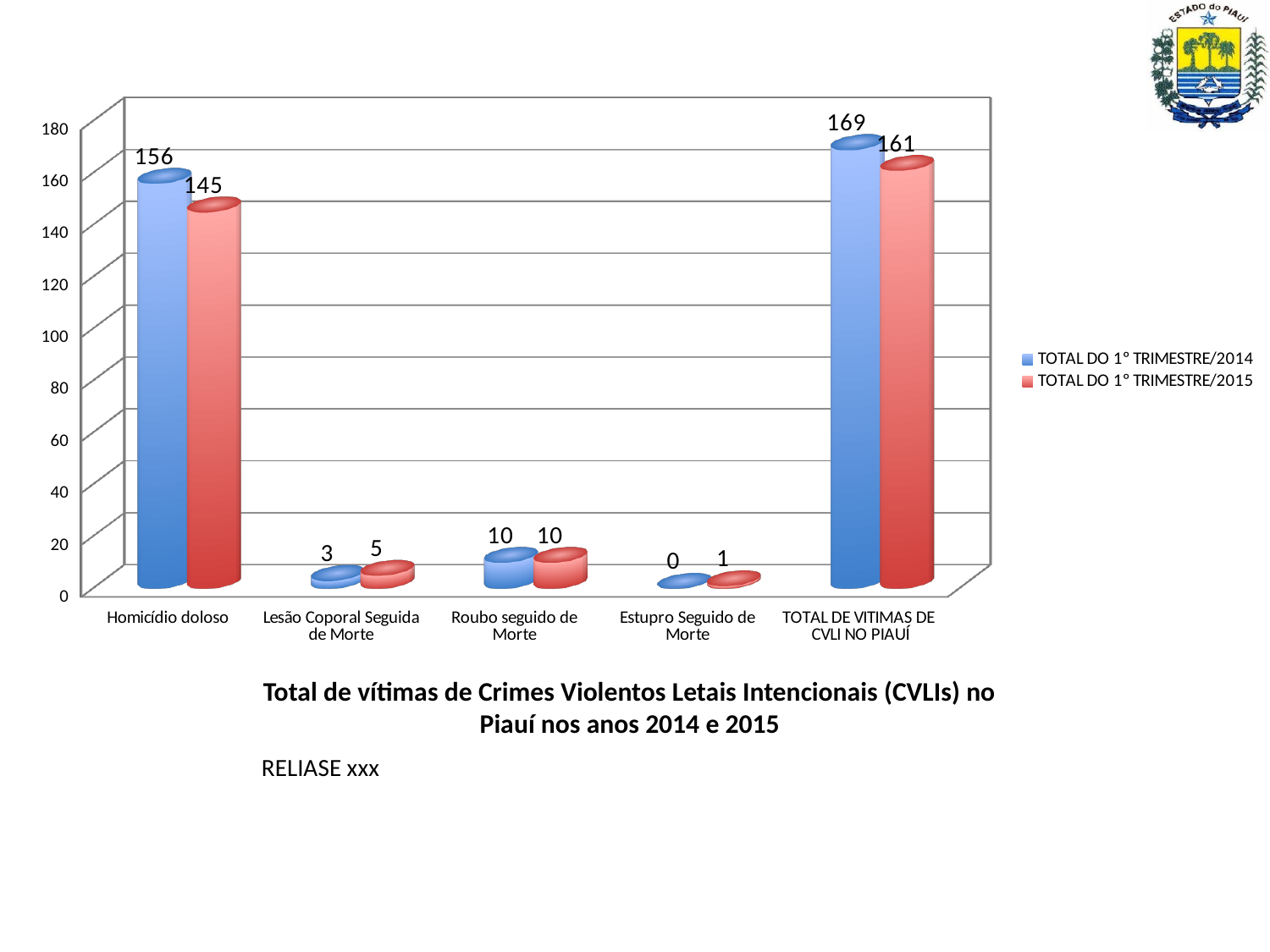
What is the value for Homicídio doloso in the TOTAL DO 1° TRIMESTRE/2015 series? 145 Which category has the lowest value in the TOTAL DO 1° TRIMESTRE/2015 series? Estupro Seguido de Morte What is the value for Estupro Seguido de Morte in the TOTAL DO 1° TRIMESTRE/2014 series? 0 What is the value for Homicídio doloso in the TOTAL DO 1° TRIMESTRE/2014 series? 156 What is the value for TOTAL DE VITIMAS DE CVLI NO PIAUÍ in the TOTAL DO 1° TRIMESTRE/2015 series? 161 What is the value for Lesão Coporal Seguida de Morte in the TOTAL DO 1° TRIMESTRE/2015 series? 5 How many series does the legend list? 2 How many categories are shown on the x axis? 5 What kind of chart is shown on the slide? Bar chart What is the difference between the 2014 and 2015 values for TOTAL DE VITIMAS DE CVLI NO PIAUÍ? 8 Which is larger for Homicídio doloso: the TOTAL DO 1° TRIMESTRE/2014 value or the TOTAL DO 1° TRIMESTRE/2015 value? TOTAL DO 1° TRIMESTRE/2014 Which category has the highest value in the TOTAL DO 1° TRIMESTRE/2014 series? TOTAL DE VITIMAS DE CVLI NO PIAUÍ